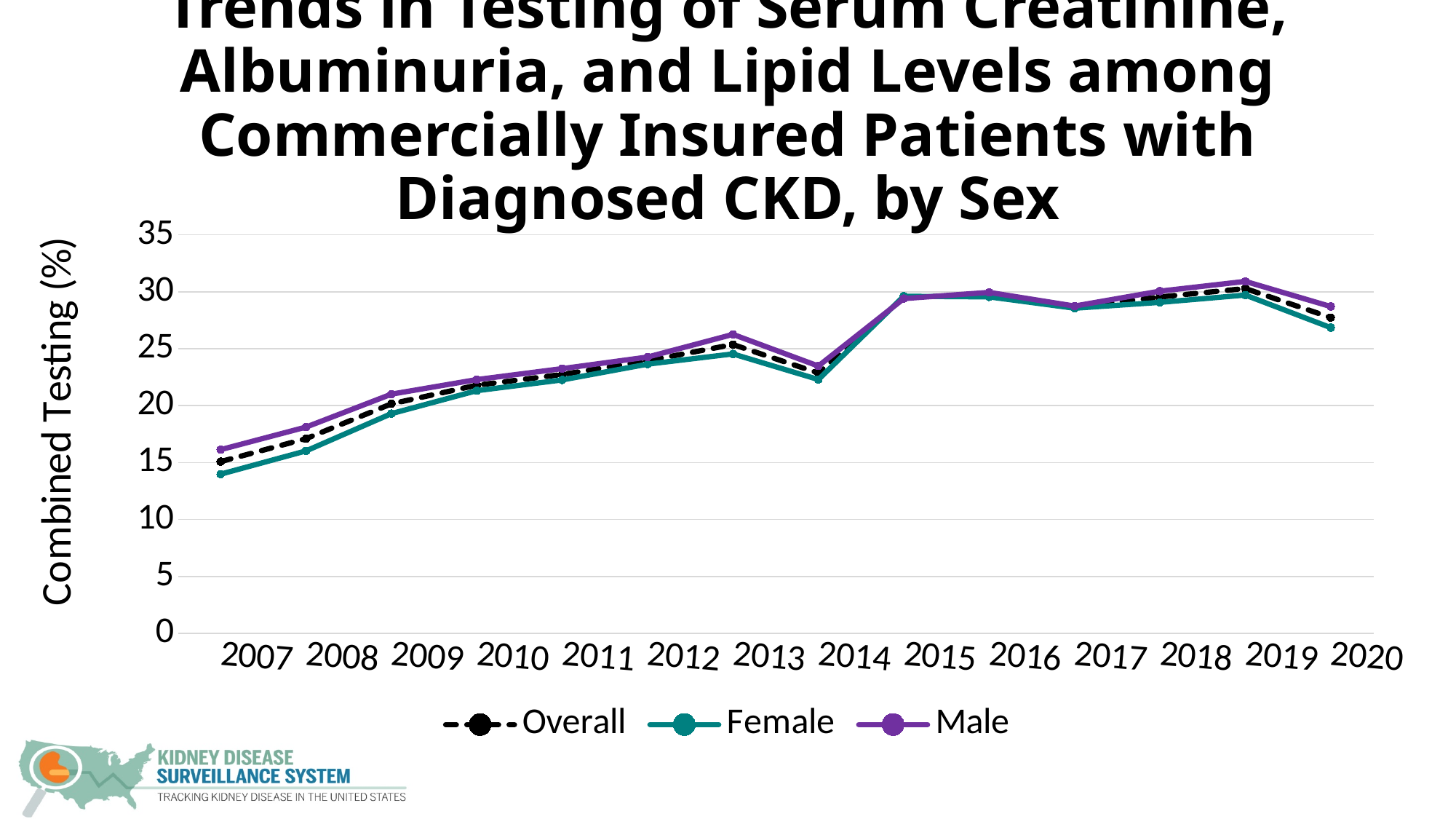
Which series are listed in the legend? Overall, Female, Male Is the value for Overall in 2014 greater or less than 20? greater What kind of chart is shown on the slide? line chart Is the value for Female in 2020 greater or less than 30? less Is the value for Male in 2019 greater or less than 30? greater In which year is the Male series at its highest? 2019 Overall, do the values for the Female series rise or fall from 2007 to 2019? rise What is the label of the y axis? Combined Testing (%) How many years are plotted along the x axis? 14 How many series does the legend list? 3 In which year is the Female series at its lowest? 2007